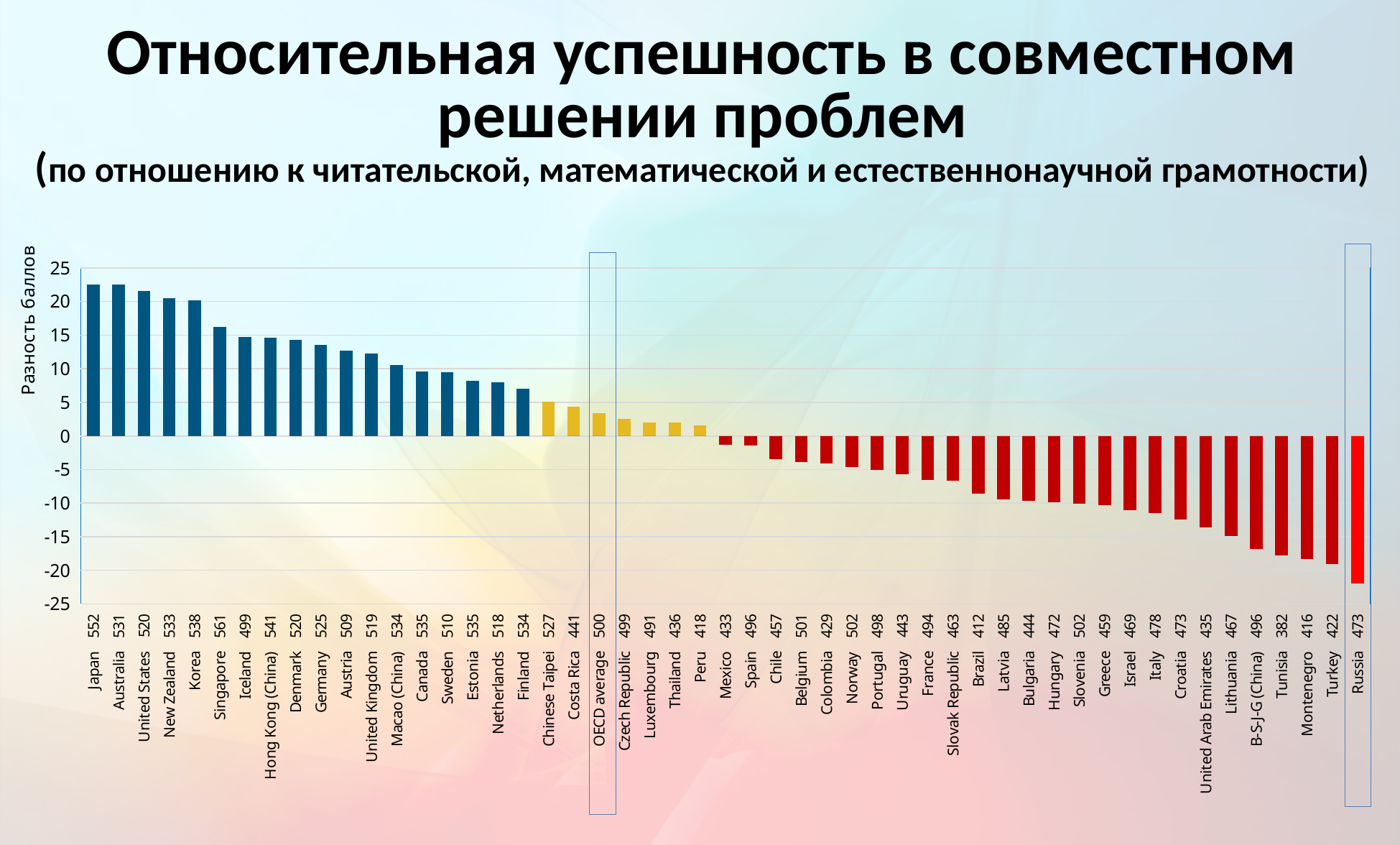
Which has the larger value, Japan or Finland? Japan Is the value for Singapore greater or less than 15? greater What kind of chart is shown on the slide? bar chart Do the values rise or fall moving from left to right along the x axis? fall Is the value for Turkey greater or less than -15? less Which has the larger value, Mexico or Turkey? Mexico Is the value for Russia greater or less than -20? less What is the label on the vertical axis of the chart? Разность баллов Which country has the lowest value in the chart? Russia